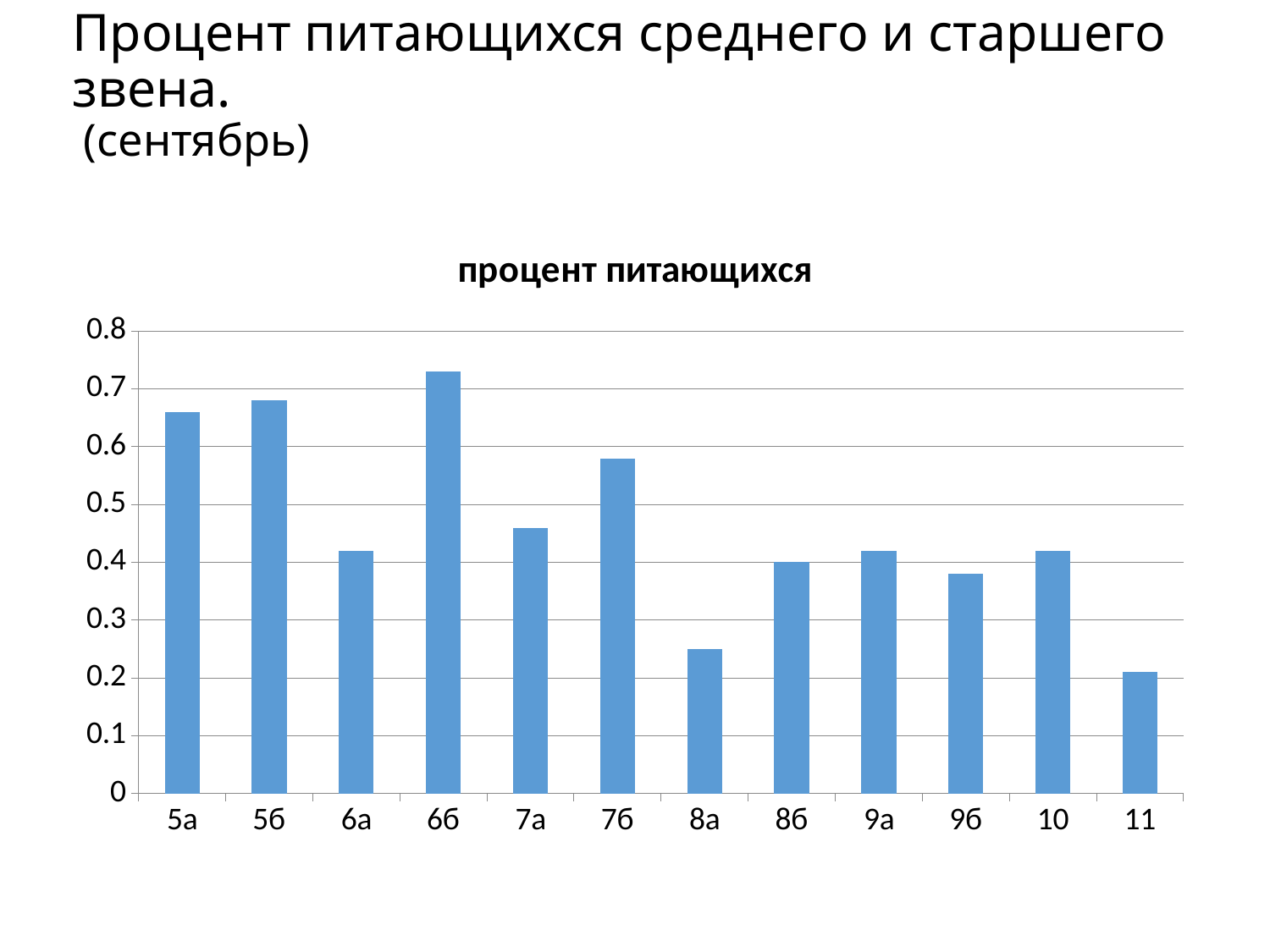
Is the value for 7а greater or less than 0.5? less Is the value for 7б greater or less than 0.5? greater Which class has the highest value in the chart? 6б Is the value for 8а greater or less than 0.3? less Which has a larger value, 7а or 7б? 7б Which has a larger value, 5а or 8а? 5а What is the title printed above the chart? процент питающихся How many classes (categories) are shown on the x axis of the chart? 12 Which class has the lowest value in the chart? 11 What kind of chart is shown on the slide? bar chart